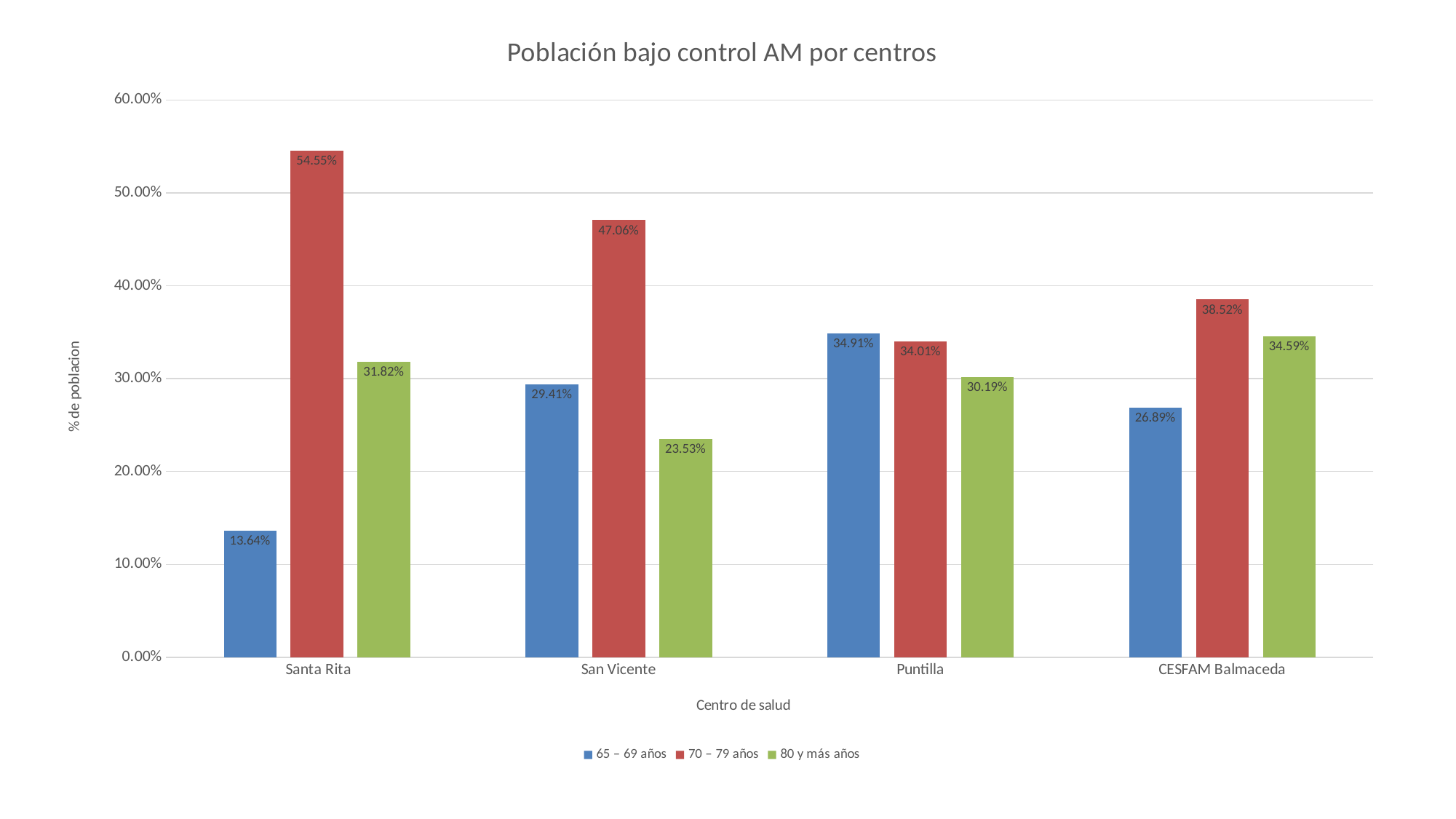
How many centros de salud are shown on the x axis? 4 Which centro de salud has the lowest value for the 65 – 69 años series? Santa Rita Which centro de salud has the highest value for the 70 – 79 años series? Santa Rita What is the value for the 65 – 69 años series at CESFAM Balmaceda? 26.89% What is the title of the chart? Población bajo control AM por centros Is the value for the 70 – 79 años series at San Vicente greater or less than 40.00%? greater What is the value for the 80 y más años series at San Vicente? 23.53% Which is larger at Puntilla: the 65 – 69 años value or the 80 y más años value? 65 – 69 años How many series does the legend list? 3 What kind of chart is shown on the slide? bar chart What is the value for the 70 – 79 años series at Santa Rita? 54.55% What is the difference between the 70 – 79 años and 65 – 69 años values at Santa Rita? 40.91%